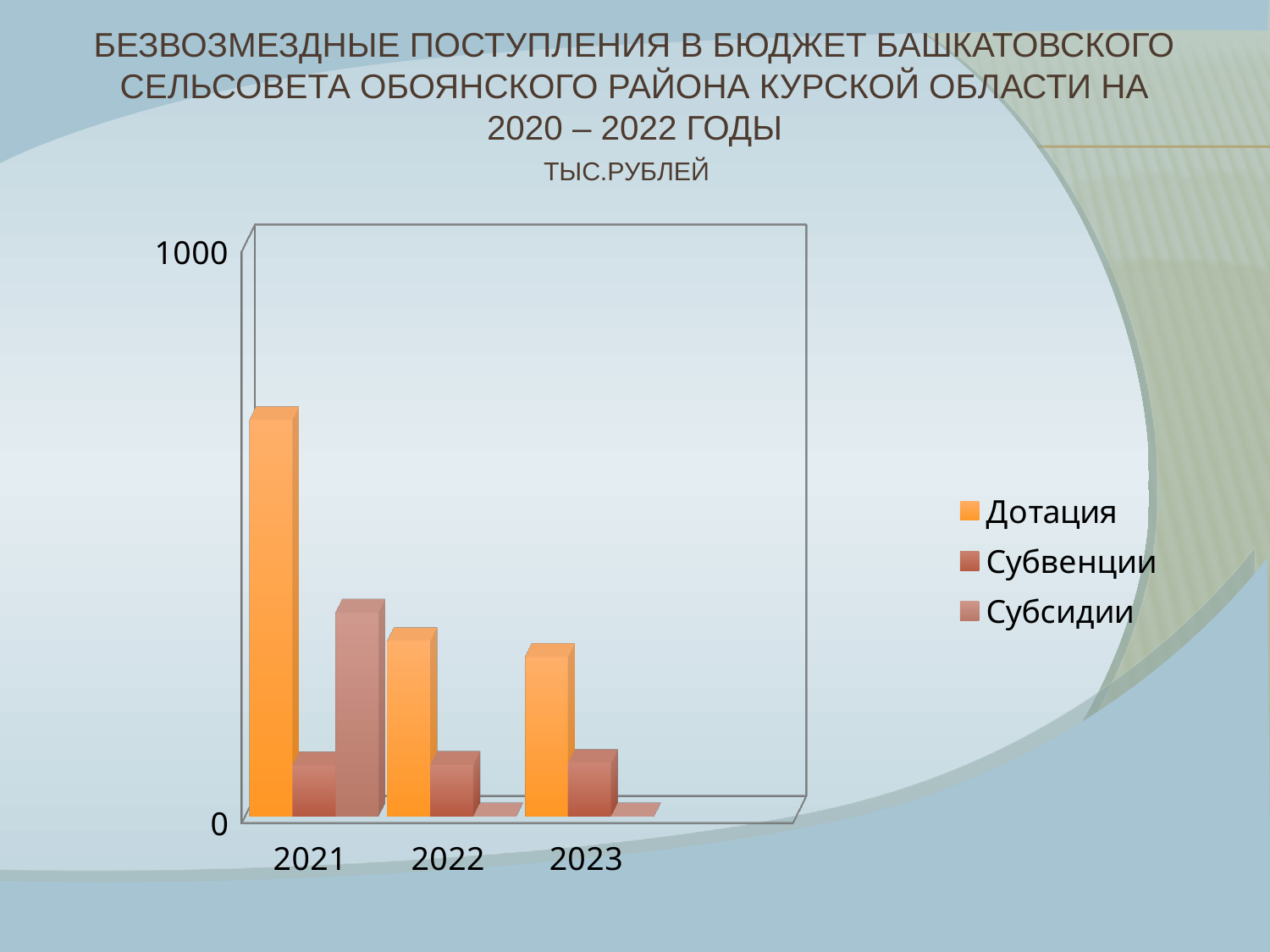
How many series does the chart legend list? 3 Which is larger in 2022: Дотация or Субсидии? Дотация Does the value for Дотация rise or fall from 2021 to 2023? fall In which year is the value for Субсидии the highest? 2021 How many years are shown on the x axis of the chart? 3 Which is larger in 2021: Дотация or Субвенции? Дотация What kind of chart is shown on the slide? bar chart In what units are the values on the chart given? тыс.рублей In which year is the value for Дотация the highest? 2021 Is the value for Дотация in 2021 greater or less than 1000? less Which series are listed in the chart legend? Дотация, Субвенции, Субсидии Which is larger: Дотация in 2021 or Дотация in 2022? Дотация in 2021